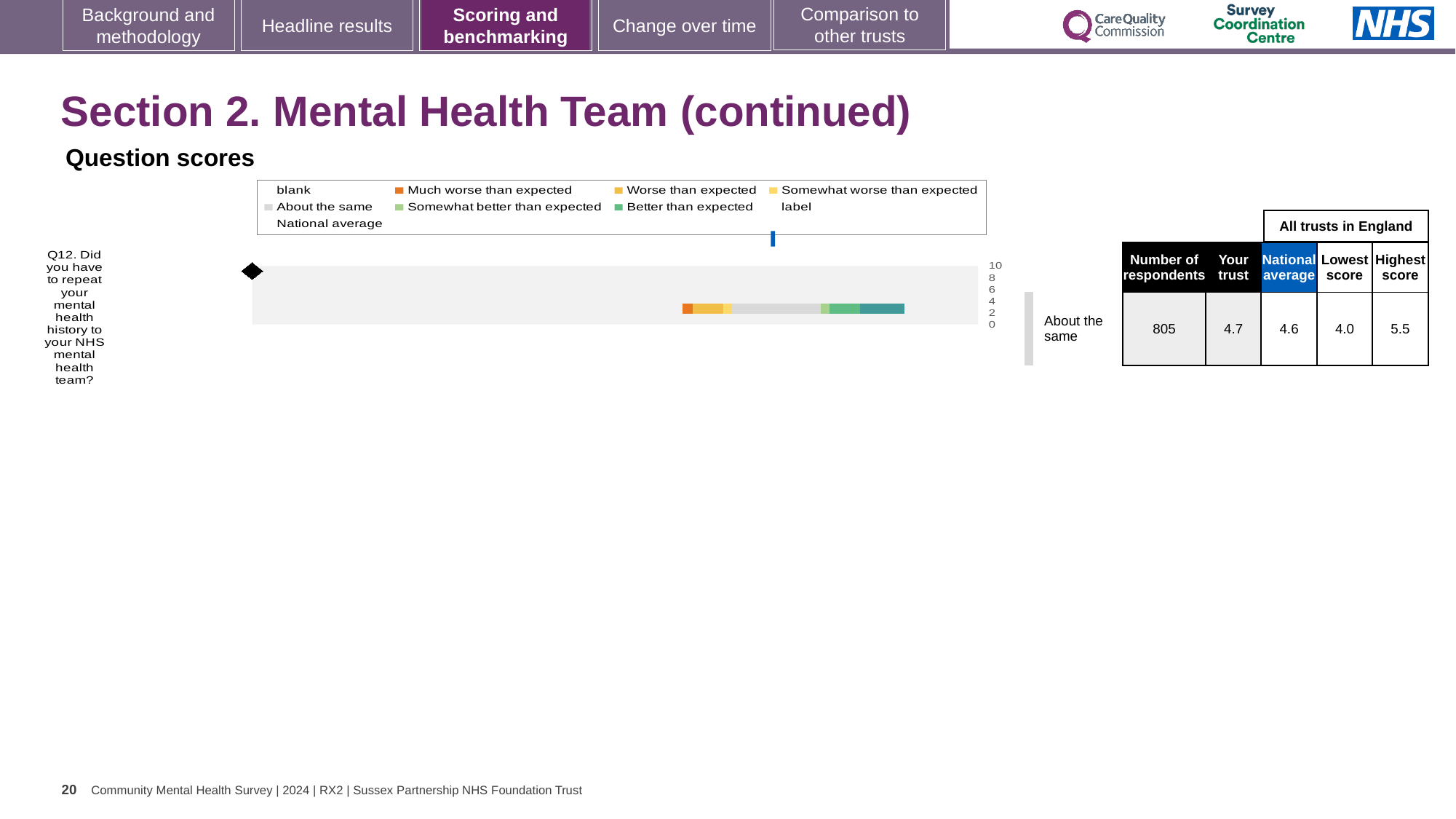
What benchmark category is Q12 assigned to on the chart? About the same What colour does the legend use for 'Much worse than expected'? Orange What is the difference between the highest score and the lowest score for Q12? 1.5 How many survey questions are plotted on the chart? 1 What is the national average score for Q12? 4.6 What kind of chart is used to show the Q12 question score? Bar chart Which is higher for Q12: the 'Your trust' score or the national average? Your trust What is the 'Your trust' score for Q12 (repeating mental health history to the NHS mental health team)? 4.7 What is the lowest score among all trusts in England for Q12? 4.0 What is the highest score among all trusts in England for Q12? 5.5 By how much does the 'Your trust' score exceed the national average for Q12? 0.1 How many respondents answered Q12? 805